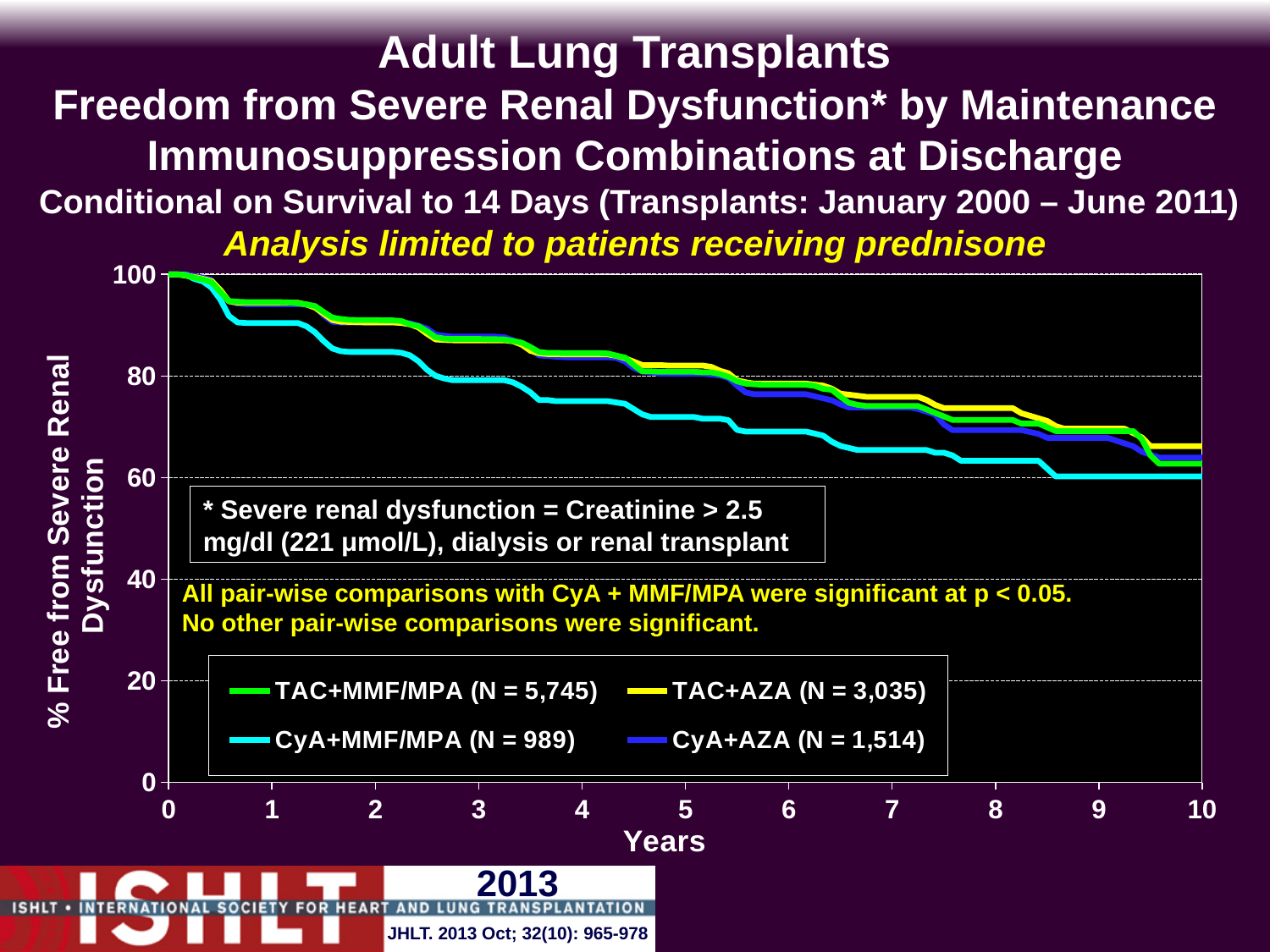
Is the value for TAC+MMF/MPA at 2 years greater or less than 80? greater Is the value for CyA+MMF/MPA at 5 years greater or less than 80? less What is the N for the CyA+AZA group shown in the legend? 1,514 How many year ticks are labelled on the x axis? 11 What kind of chart is shown on the slide? line chart How many series does the legend list? 4 What is the label of the y axis? % Free from Severe Renal Dysfunction Which series has the lowest value at 10 years? CyA+MMF/MPA At 5 years, which is higher: TAC+MMF/MPA or CyA+MMF/MPA? TAC+MMF/MPA Is the value for TAC+AZA at 10 years greater or less than 60? greater Do the values for TAC+MMF/MPA rise or fall as the years increase? fall